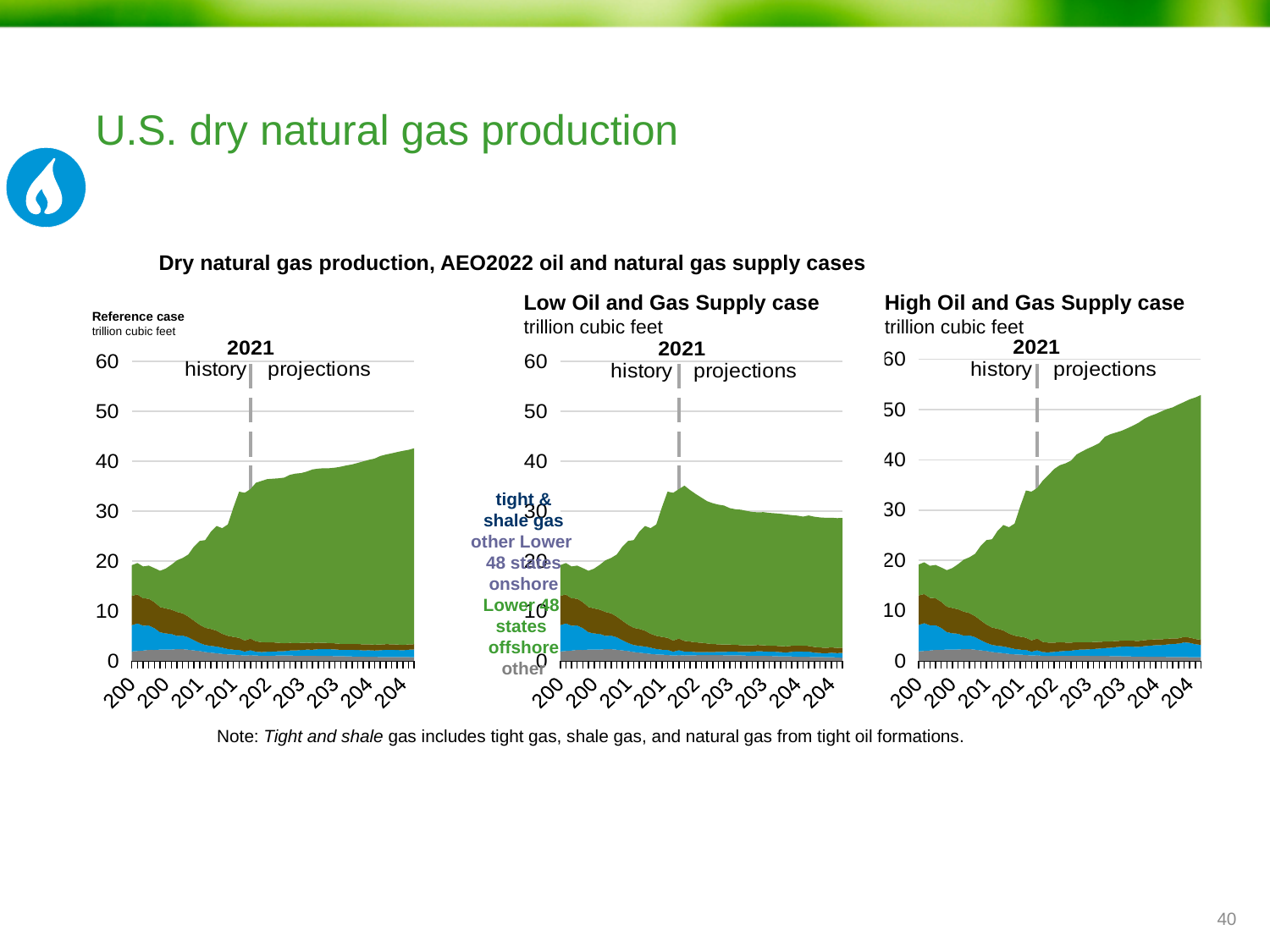
What kind of chart is used for the Reference case? area chart What unit is used on the y axis of the charts? trillion cubic feet Which of the three cases shows the highest total production at the end of the projection period? High Oil and Gas Supply case In the Low Oil and Gas Supply case chart, is the total production at the end of the projection period greater or less than 40 trillion cubic feet? less In the Low Oil and Gas Supply case chart, does total production rise or fall after its peak around 2021? fall What year does the dashed line separating history from projections mark? 2021 Which of the three cases shows the lowest total production at the end of the projection period? Low Oil and Gas Supply case In the High Oil and Gas Supply case chart, does total production rise or fall over the projection period? rise In the Reference case chart, is the total production at the end of the projection period greater or less than 30 trillion cubic feet? greater In the High Oil and Gas Supply case chart, is the total production at the end of the projection period greater or less than 50 trillion cubic feet? greater How many series does the legend list for the dry natural gas production charts? 4 How many charts are shown on the slide? 3